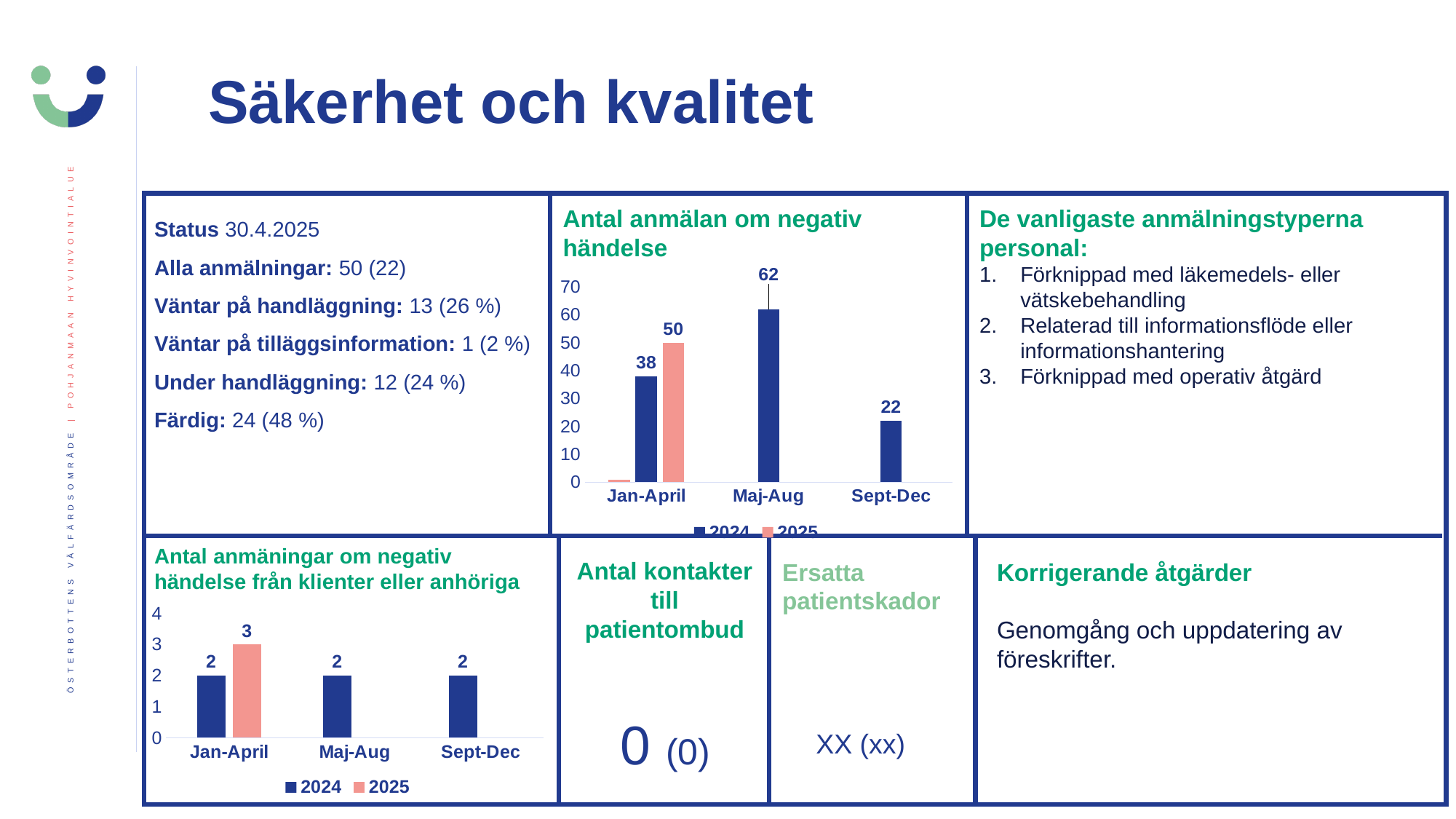
In the chart 'Antal anmäningar om negativ händelse från klienter eller anhöriga', how many periods are shown on the x axis? 3 In the chart 'Antal anmälan om negativ händelse', what is the difference between the 2025 and 2024 values for Jan-April? 12 In the chart 'Antal anmälan om negativ händelse', what is the 2025 value for Jan-April? 50 In the chart 'Antal anmälan om negativ händelse', what is the 2024 value for Maj-Aug? 62 In the chart 'Antal anmälan om negativ händelse', how many series does the legend list? 2 In the chart 'Antal anmälan om negativ händelse', is the 2024 value for Sept-Dec greater or less than 30? less In the chart 'Antal anmäningar om negativ händelse från klienter eller anhöriga', what is the 2024 value for Sept-Dec? 2 In the chart 'Antal anmälan om negativ händelse', which period has the highest 2024 value? Maj-Aug In the chart 'Antal anmäningar om negativ händelse från klienter eller anhöriga', what is the 2025 value for Jan-April? 3 In the chart 'Antal anmälan om negativ händelse', which period has the lowest 2024 value? Sept-Dec In the chart 'Antal anmäningar om negativ händelse från klienter eller anhöriga', which is larger for Jan-April, the 2024 or the 2025 value? 2025 What kind of chart is 'Antal anmälan om negativ händelse'? bar chart